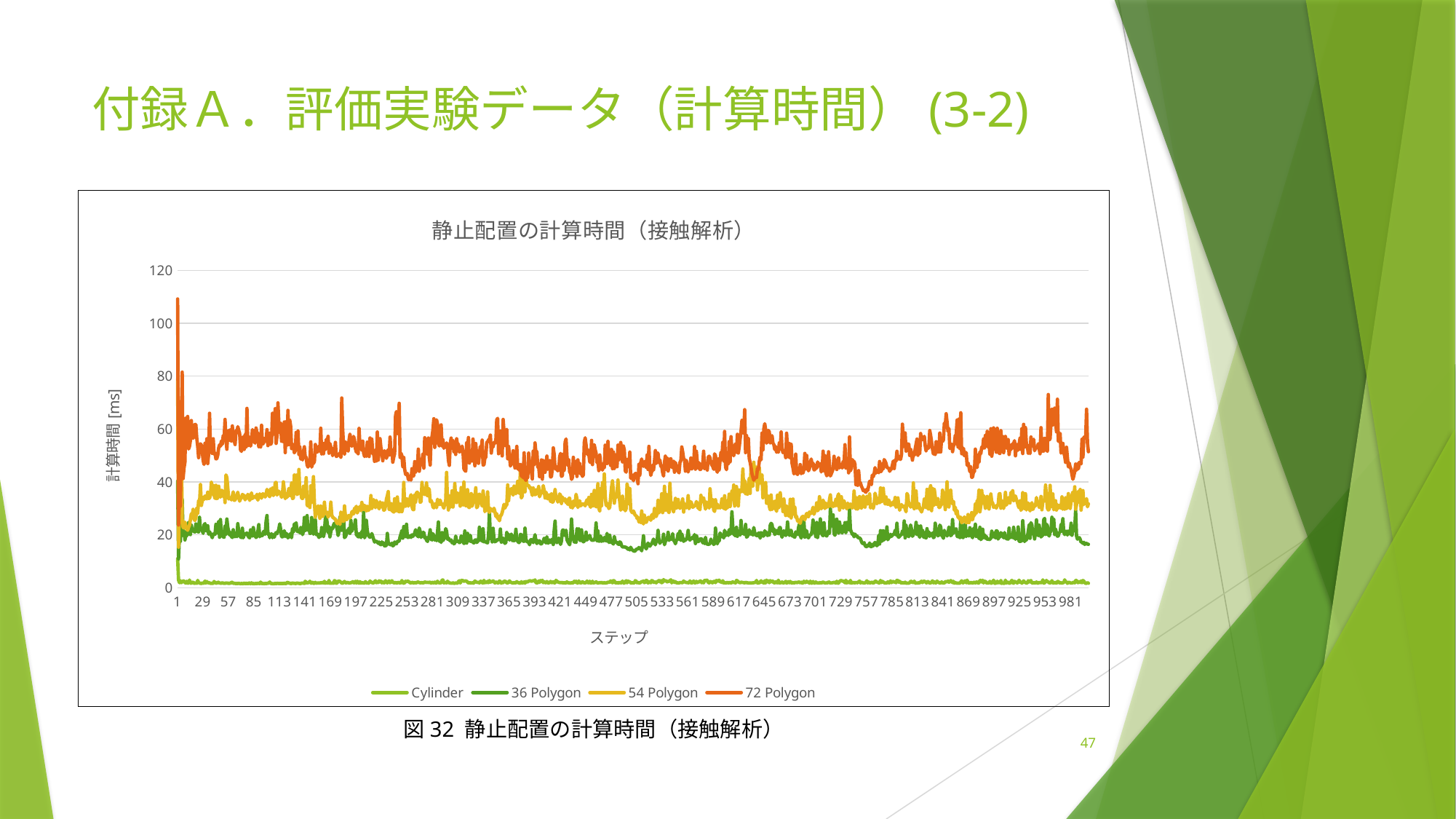
How many series does the legend list? 4 Which series has the lowest computation time across the steps? Cylinder What kind of chart is shown on the slide? line chart Which series has the highest computation time across the steps? 72 Polygon Which series is higher over most of the steps, 36 Polygon or Cylinder? 36 Polygon Is the value for Cylinder greater or less than 20 ms across the steps? less Which series is higher over most of the steps, 54 Polygon or 36 Polygon? 54 Polygon What is the label of the vertical axis? 計算時間 [ms] Is the value for 72 Polygon at step 1 greater or less than 100 ms? greater What is the title of the chart? 静止配置の計算時間（接触解析）